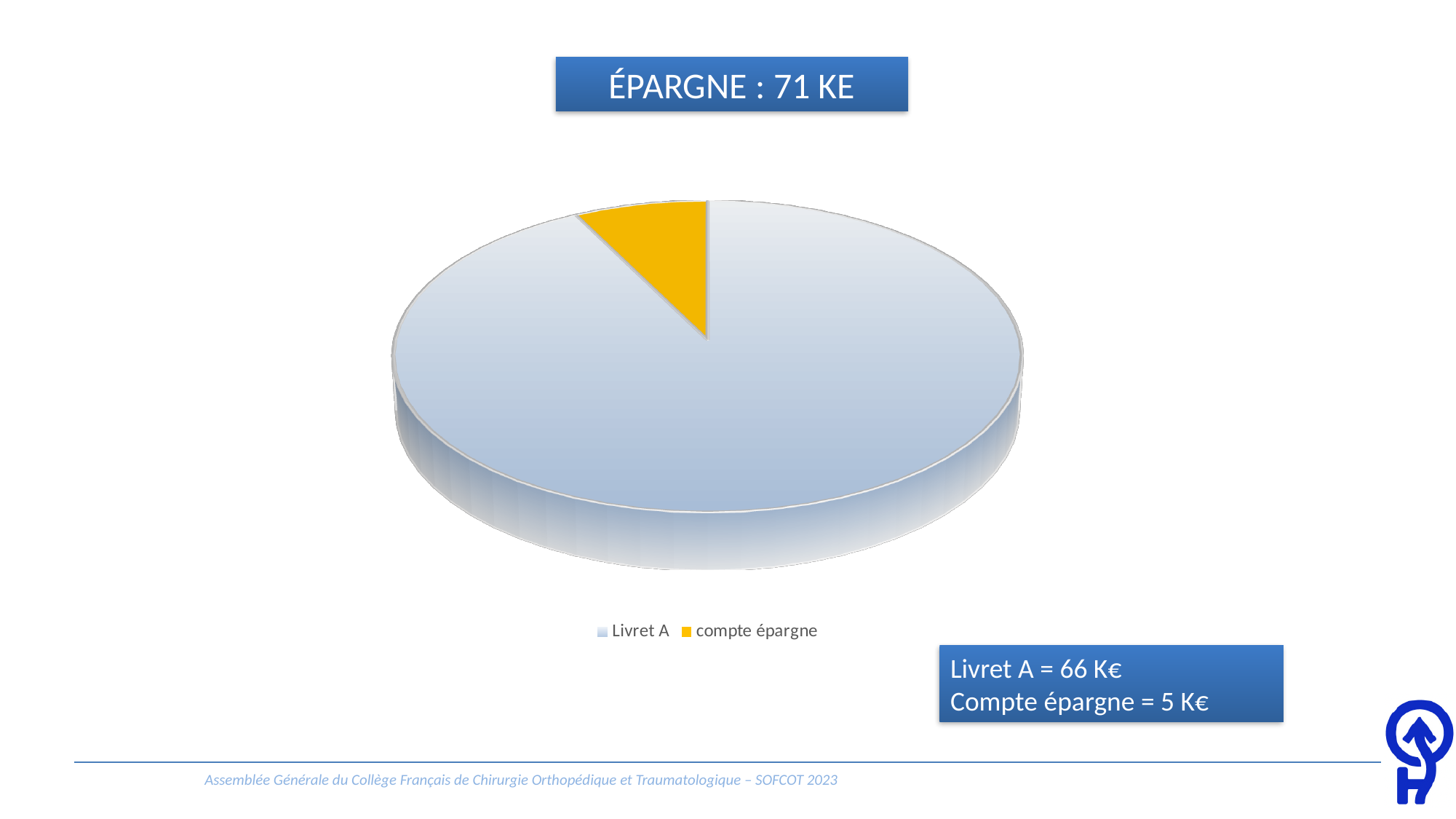
Which slice of the pie chart is the smallest? compte épargne What kind of chart is shown on the slide? Pie chart What is the title shown above the pie chart? ÉPARGNE : 71 KE How many entries does the legend of the pie chart list? 2 What is the total savings amount shown in the slide title? 71 KE Which slice of the pie chart is the largest? Livret A What is the value for Livret A? 66 K€ Which is larger, Livret A or Compte épargne? Livret A What is the difference between the Livret A value and the Compte épargne value? 61 K€ What is the value for Compte épargne? 5 K€ How many slices does the pie chart have? 2 What colour is the compte épargne slice in the pie chart? Yellow